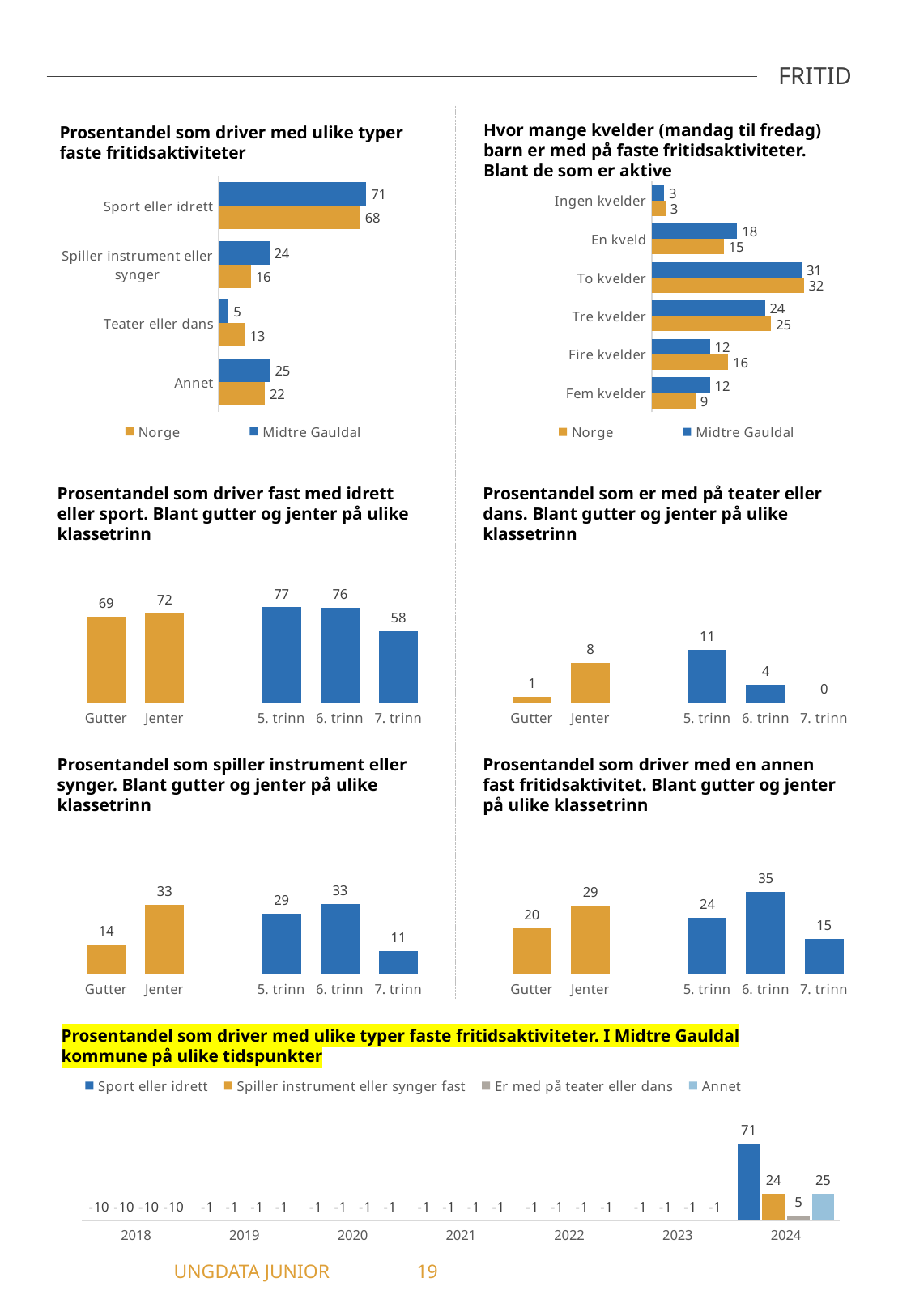
In the chart 'Prosentandel som driver med ulike typer faste fritidsaktiviteter', what is the difference between Norge and Midtre Gauldal for 'Teater eller dans'? 8 How many series does the legend list in the bottom chart 'Prosentandel som driver med ulike typer faste fritidsaktiviteter. I Midtre Gauldal kommune på ulike tidspunkter'? 4 How many categories are shown in the chart 'Hvor mange kvelder (mandag til fredag) barn er med på faste fritidsaktiviteter'? 6 In the chart 'Prosentandel som driver fast med idrett eller sport', which category has the lowest value? 7. trinn In the chart 'Prosentandel som er med på teater eller dans', what is the value for 7. trinn? 0 In the chart 'Prosentandel som driver fast med idrett eller sport', what is the value for Jenter? 72 What kind of chart is the bottom chart 'Prosentandel som driver med ulike typer faste fritidsaktiviteter. I Midtre Gauldal kommune på ulike tidspunkter'? Bar chart In the chart 'Prosentandel som driver med ulike typer faste fritidsaktiviteter', what is the value for Midtre Gauldal for 'Sport eller idrett'? 71 In the chart 'Hvor mange kvelder (mandag til fredag) barn er med på faste fritidsaktiviteter', which category has the highest value for Midtre Gauldal? To kvelder In the chart 'Prosentandel som spiller instrument eller synger', which is larger, the value for Gutter or the value for Jenter? Jenter In the chart 'Prosentandel som driver med en annen fast fritidsaktivitet', what is the difference between 6. trinn and 7. trinn? 20 In the chart 'Hvor mange kvelder (mandag til fredag) barn er med på faste fritidsaktiviteter', what is the Norge value for 'Fire kvelder'? 16